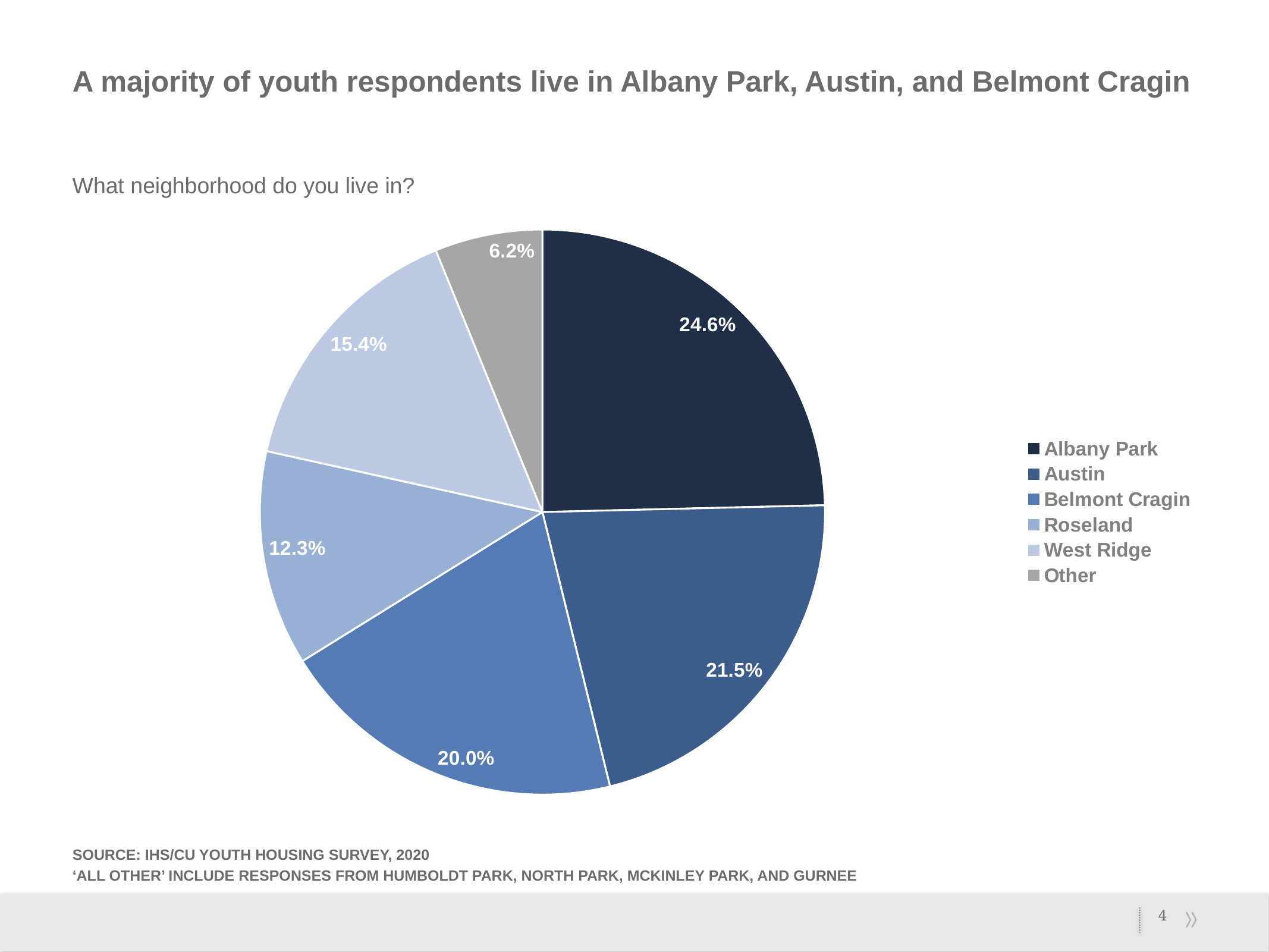
What share of youth respondents live in West Ridge? 15.4% What share of youth respondents live in Belmont Cragin? 20.0% Which neighborhood has the largest share of youth respondents? Albany Park What share of youth respondents live in Roseland? 12.3% Which has a larger share of respondents, West Ridge or Roseland? West Ridge What is the difference in percentage points between the Albany Park and Roseland shares? 12.3 What share of youth respondents fall into the Other category? 6.2% Which category has the smallest share of youth respondents? Other What kind of chart is shown on the slide? Pie chart What share of youth respondents live in Austin? 21.5% What share of youth respondents live in Albany Park? 24.6% How many categories does the pie chart show? 6